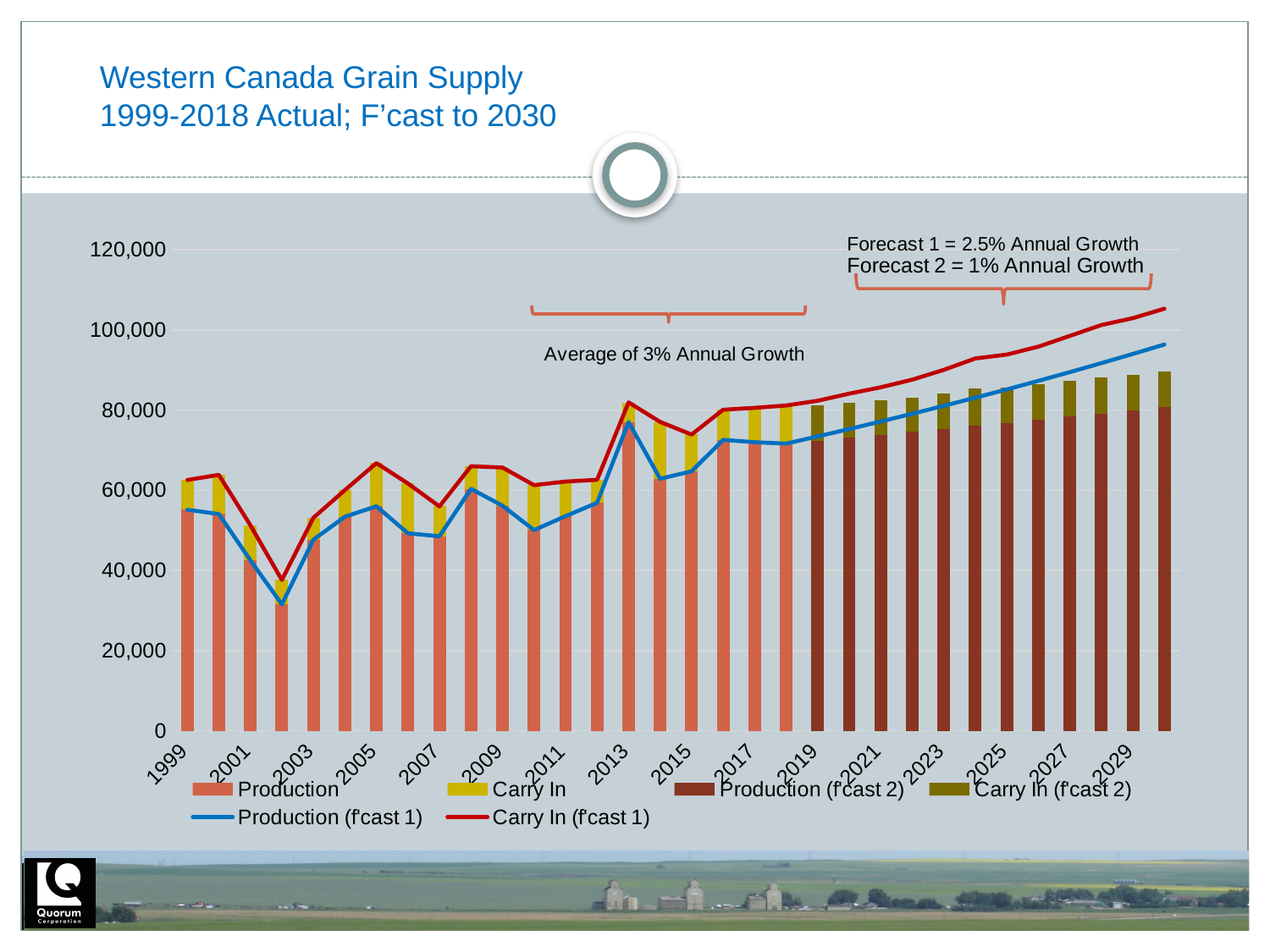
What annual growth rate does the bracket annotation over the 2010-2018 period state? Average of 3% Annual Growth Do the forecast lines rise or fall from 2019 to 2030? rise According to the annotation on the chart, what annual growth rate does Forecast 1 assume? 2.5% Annual Growth Is the Production value for 1999 greater or less than 60,000? less Is the Carry In (f'cast 1) line value at 2030 greater or less than 100,000? greater Is the Production value for 2002 greater or less than 40,000? less How many series does the legend list? 6 Which is larger, the Production bar for 2013 or the Production bar for 2014? 2013 Which year has the lowest total stacked bar? 2002 What kind of chart is shown on the slide? A combined bar and line chart (stacked bars with lines)